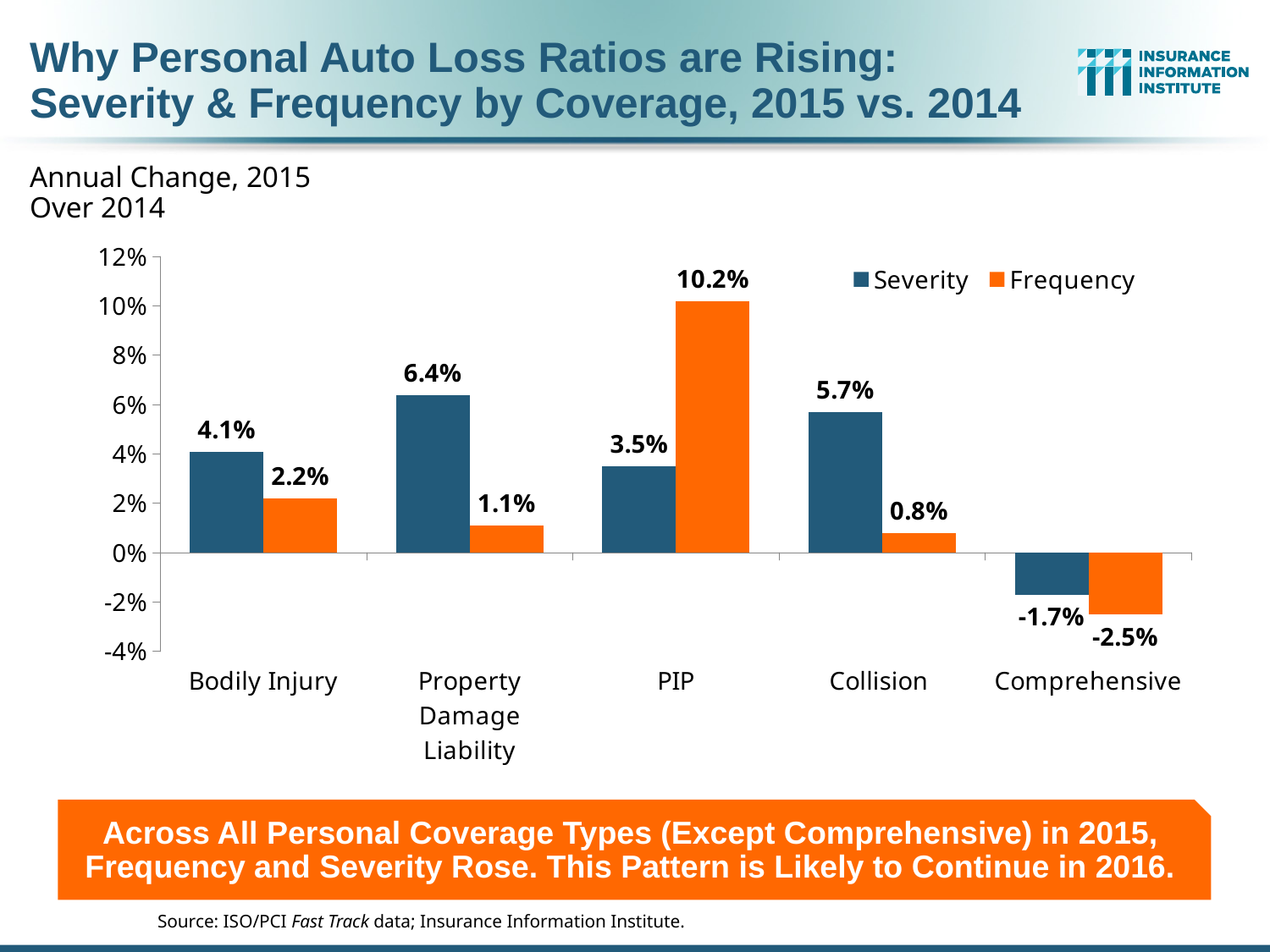
Which colour represents the Frequency series? Orange What is the Severity value for Collision? 5.7% What kind of chart is shown on the slide? Bar chart What is the difference between the Frequency and Severity values for PIP? 6.7% What is the Frequency value for Comprehensive? -2.5% What is the Frequency value for PIP? 10.2% How many series does the legend list? 2 Which coverage has the lowest Frequency value? Comprehensive Which coverage has the highest Severity value? Property Damage Liability How many coverage categories are shown on the x axis? 5 Which is larger for Collision, Severity or Frequency? Severity What is the Severity value for Bodily Injury? 4.1%